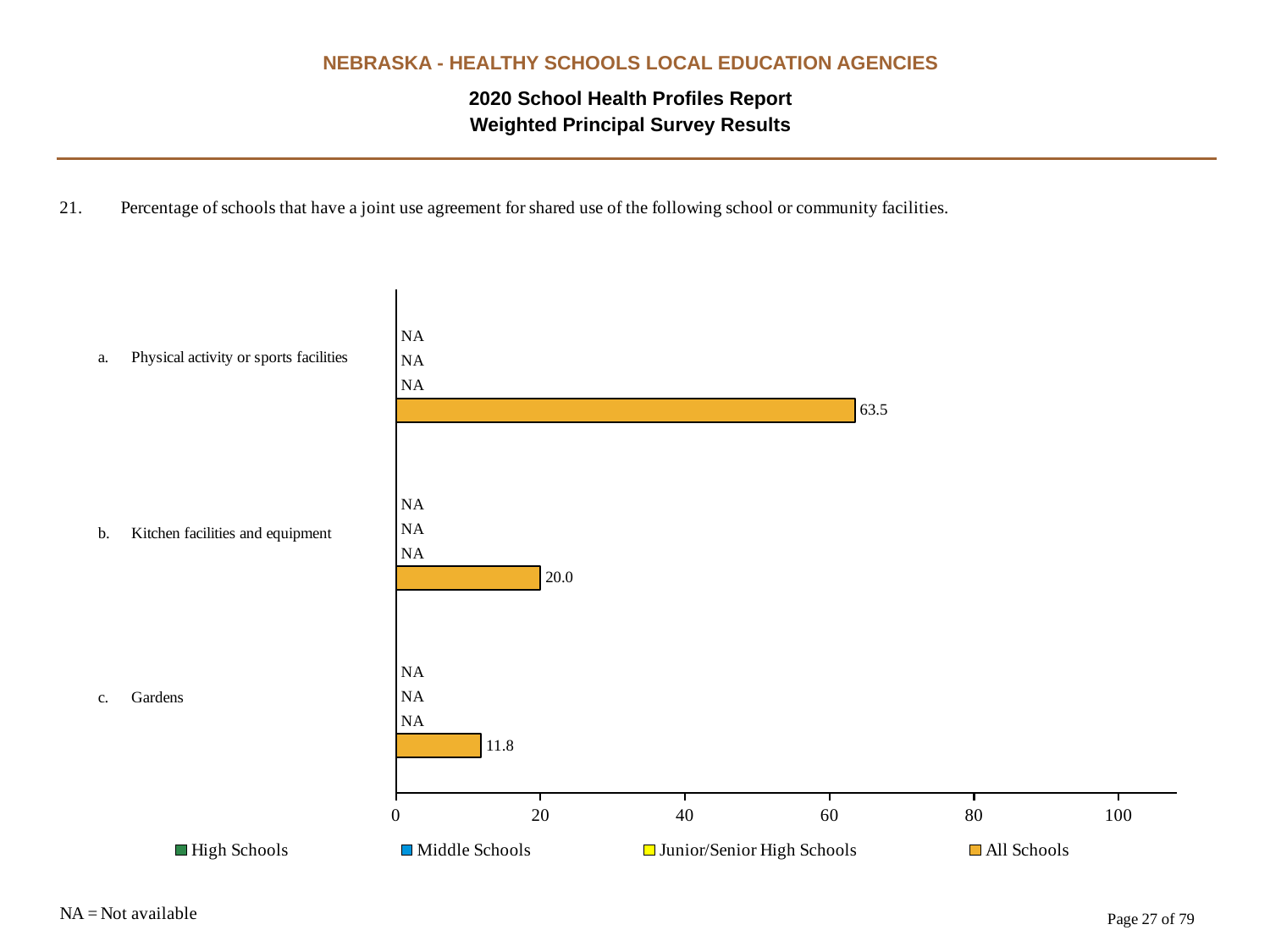
How many facility categories are shown on the chart? 3 What is the difference between the All Schools values for Physical activity or sports facilities and Kitchen facilities and equipment? 43.5 What is the value for All Schools for Physical activity or sports facilities? 63.5 What is the value for All Schools for Gardens? 11.8 How many series does the legend list? 4 What is the difference between the All Schools values for Kitchen facilities and equipment and Gardens? 8.2 Which facility has the highest All Schools value? Physical activity or sports facilities Which facility has the lowest All Schools value? Gardens What is the value for All Schools for Kitchen facilities and equipment? 20.0 Which is larger for All Schools: Kitchen facilities and equipment or Gardens? Kitchen facilities and equipment What kind of chart is shown on the slide? Bar chart Is the All Schools value for Physical activity or sports facilities greater or less than 60? greater